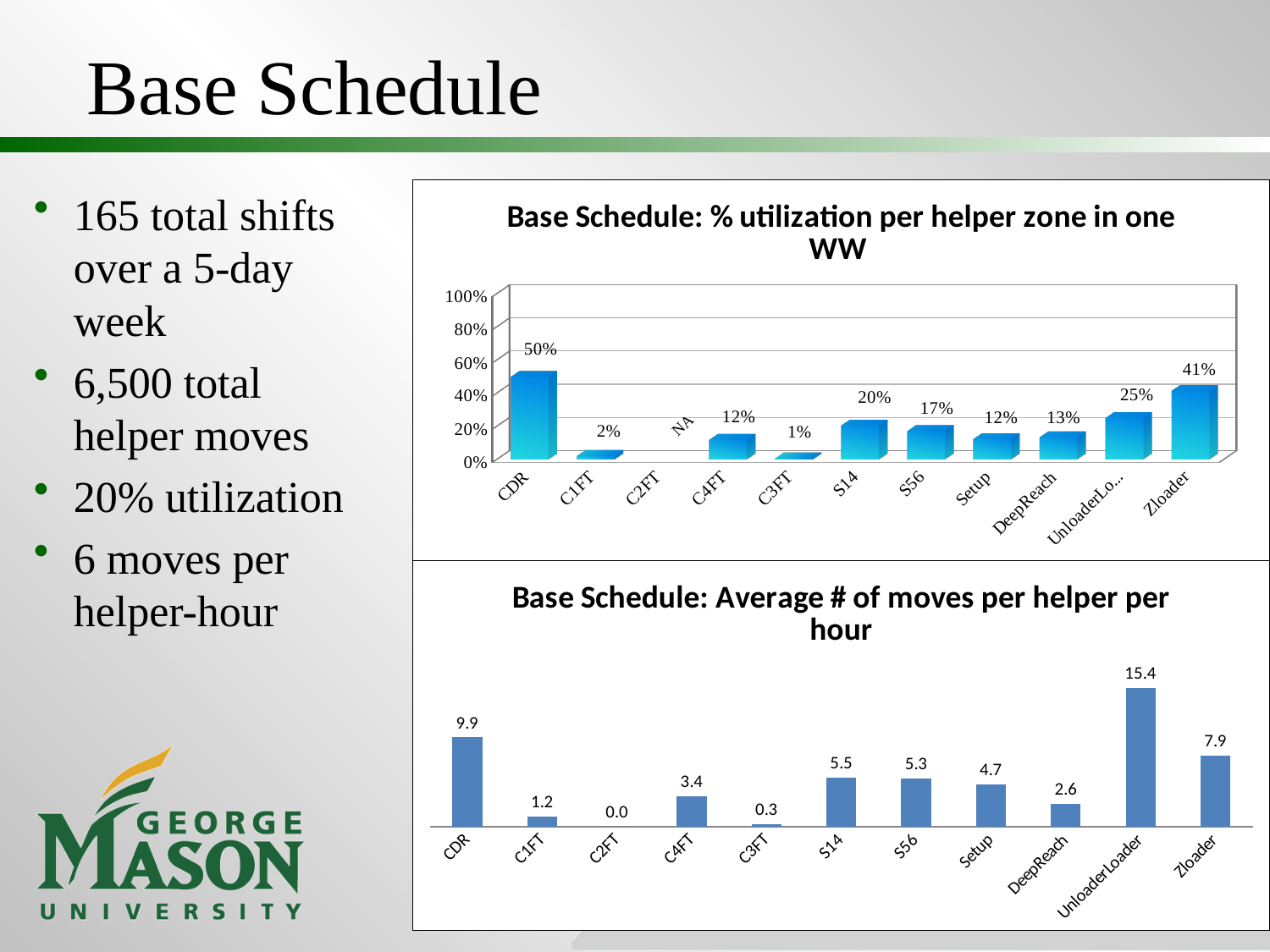
In the top chart (% utilization per helper zone), is the utilization for C3FT greater or less than 20%? less What kind of chart is the bottom chart (Average # of moves per helper per hour)? bar chart In the bottom chart (Average # of moves per helper per hour), what is the value for Setup? 4.7 How many helper zones are shown on the x axis of the bottom chart (Average # of moves per helper per hour)? 11 In the top chart (% utilization per helper zone), which helper zone has the highest utilization? CDR In the bottom chart (Average # of moves per helper per hour), which helper zone has the lowest value? C2FT In the top chart (% utilization per helper zone), what is the difference between the utilization of S14 and S56? 3% In the top chart (% utilization per helper zone), what is the utilization for Zloader? 41% In the bottom chart (Average # of moves per helper per hour), what is the difference between the values for UnloaderLoader and CDR? 5.5 In the top chart (% utilization per helper zone), what is the utilization for CDR? 50% In the bottom chart (Average # of moves per helper per hour), which is larger, the value for CDR or the value for Zloader? CDR In the bottom chart (Average # of moves per helper per hour), what is the value for UnloaderLoader? 15.4